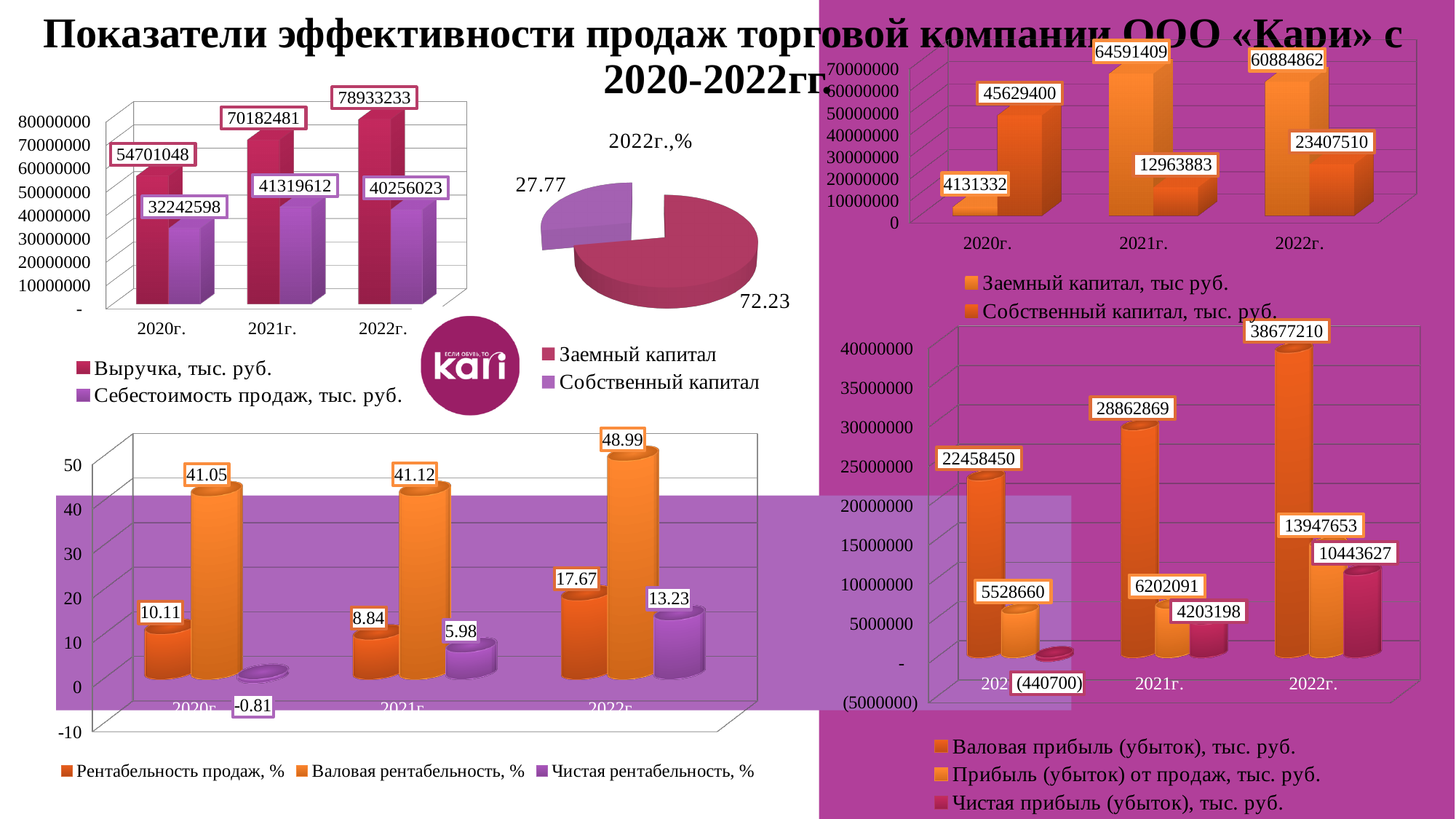
In the bottom-left bar chart, does Валовая рентабельность, % rise or fall from 2020г. to 2022г.? rise In the bottom-right bar chart, in which year is Валовая прибыль (убыток), тыс. руб. lowest? 2020г. In the top-right bar chart, in which year is Собственный капитал, тыс руб. highest? 2020г. In the top-right bar chart, what is the value of Заемный капитал, тыс руб. for 2021г.? 64591409 In the pie chart titled 2022г.,%, what share does Заемный капитал have? 72.23 How many series does the legend of the bottom-left bar chart list? 3 In the top-left bar chart, what is the value of Выручка, тыс. руб. for 2022г.? 78933233 In the bottom-right bar chart, what is the value of Чистая прибыль (убыток), тыс. руб. for 2022г.? 10443627 In the bottom-left bar chart, what is the value of Чистая рентабельность, % for 2020г.? -0.81 In the top-left bar chart, what is the value of Себестоимость продаж, тыс. руб. for 2020г.? 32242598 In the pie chart titled 2022г.,%, which slice is larger, Заемный капитал or Собственный капитал? Заемный капитал In the top-left bar chart, what is the difference between Выручка and Себестоимость продаж for 2021г.? 28862869